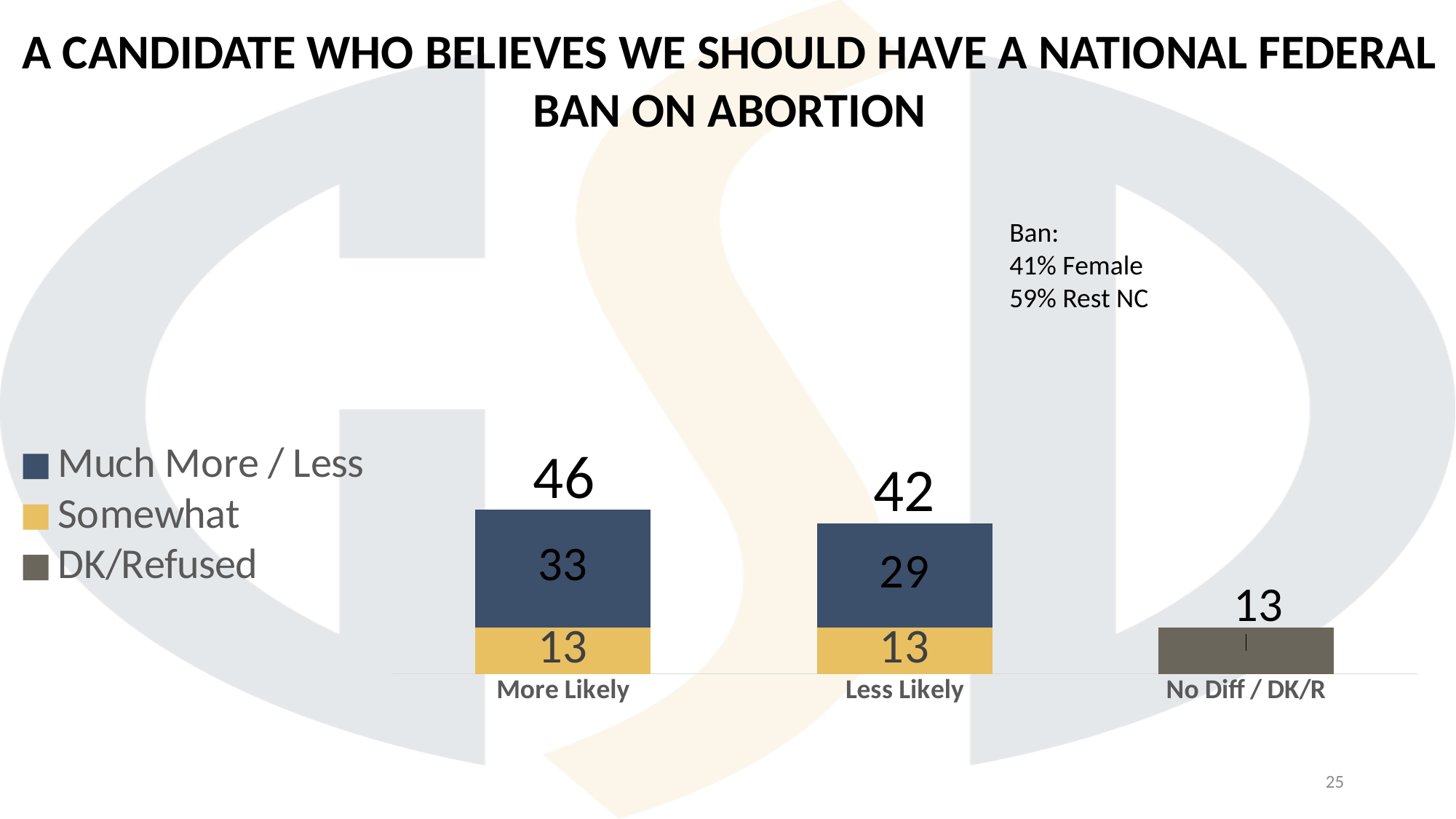
How many series does the legend list? 3 Which category has the highest total? More Likely How many categories are shown on the x axis? 3 Which category has the lowest total? No Diff / DK/R What kind of chart is shown on the slide? Stacked bar chart What is the value shown for the No Diff / DK/R bar? 13 What is the total shown above the More Likely stacked bar? 46 What is the 'Much More / Less' value for the More Likely bar? 33 What is the difference between the 'Much More / Less' values for More Likely and Less Likely? 4 Which is larger, the total for More Likely or the total for Less Likely? More Likely What is the 'Somewhat' value for the Less Likely bar? 13 What is the total shown above the Less Likely stacked bar? 42